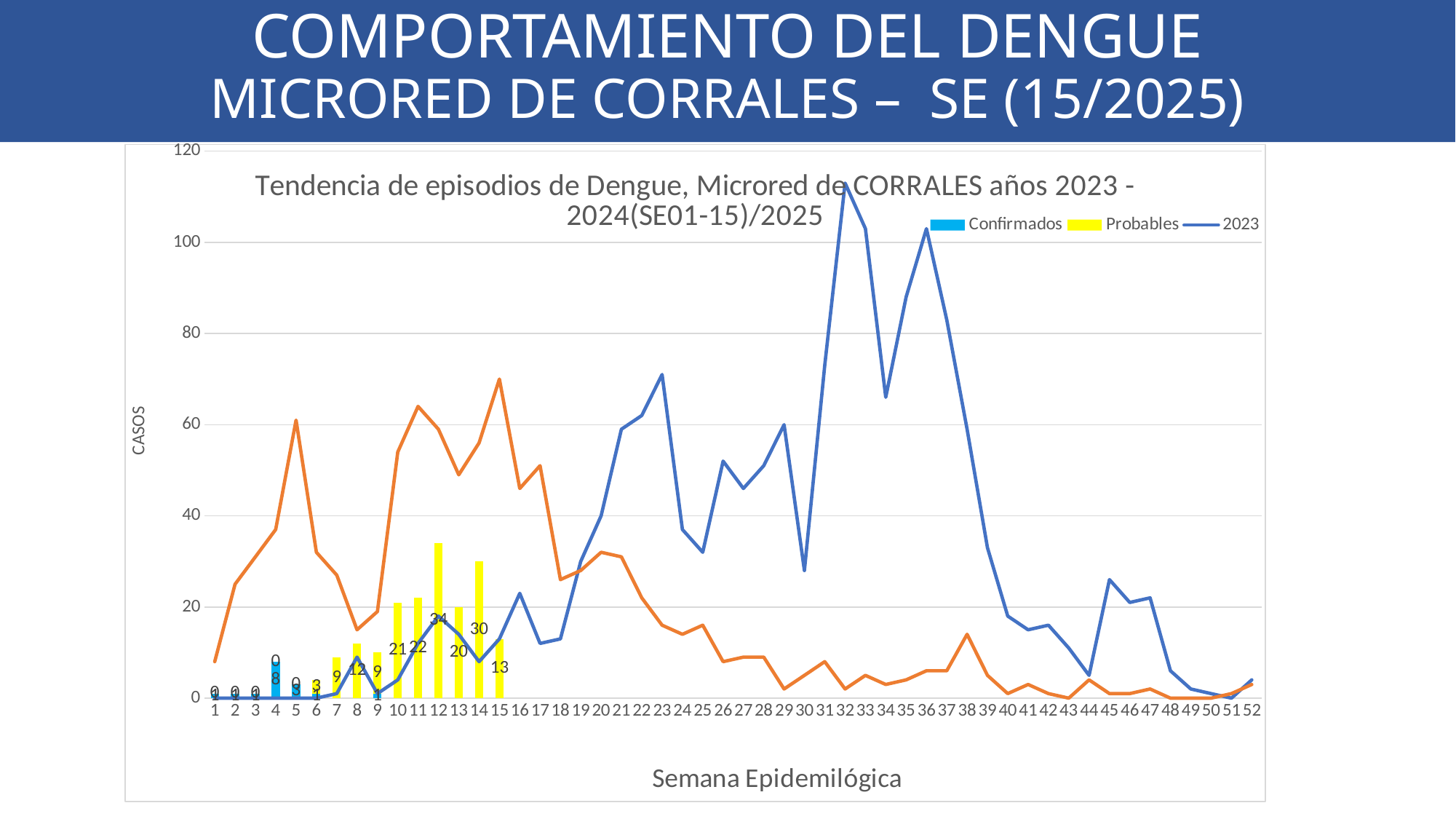
Which week has a larger Probables value, week 13 or week 15? Week 13 How many series does the legend list? 3 What kind of chart is shown on the slide? A combined bar and line chart What is the difference between the Probables values in week 12 and week 14? 4 What is the value of Probables in week 12? 34 What is the difference between the Probables values in week 11 and week 10? 1 How many epidemiological weeks are shown on the x axis? 52 Is the value of the 2023 line in week 32 greater or less than 100? greater In which week is the Probables value highest? 12 Is the value of the 2023 line in week 23 greater or less than 60? greater What is the value of Probables in week 14? 30 What is the value of Probables in week 7? 9